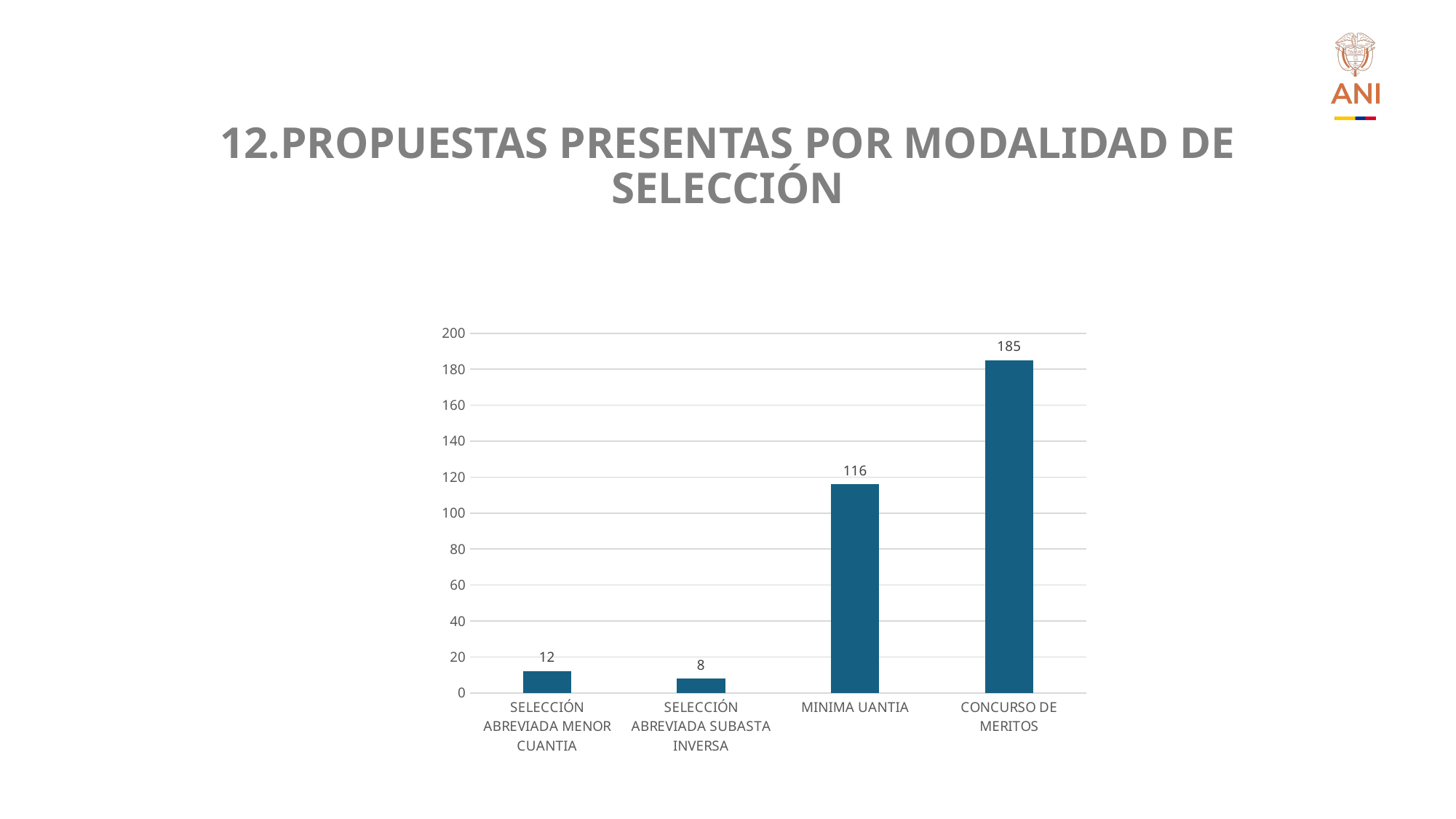
What is the value for CONCURSO DE MERITOS? 185 What is the value for SELECCIÓN ABREVIADA SUBASTA INVERSA? 8 What is the value for SELECCIÓN ABREVIADA MENOR CUANTIA? 12 What is the difference between the values for CONCURSO DE MERITOS and MINIMA UANTIA? 69 What is the difference between the values for SELECCIÓN ABREVIADA MENOR CUANTIA and SELECCIÓN ABREVIADA SUBASTA INVERSA? 4 What is the value for MINIMA UANTIA? 116 Is the value for MINIMA UANTIA greater or less than 100? greater Which category has the lowest value? SELECCIÓN ABREVIADA SUBASTA INVERSA How many categories are shown on the chart? 4 What kind of chart is shown on the slide? bar chart Which category has the highest value? CONCURSO DE MERITOS Which is larger, the value for MINIMA UANTIA or the value for SELECCIÓN ABREVIADA MENOR CUANTIA? MINIMA UANTIA